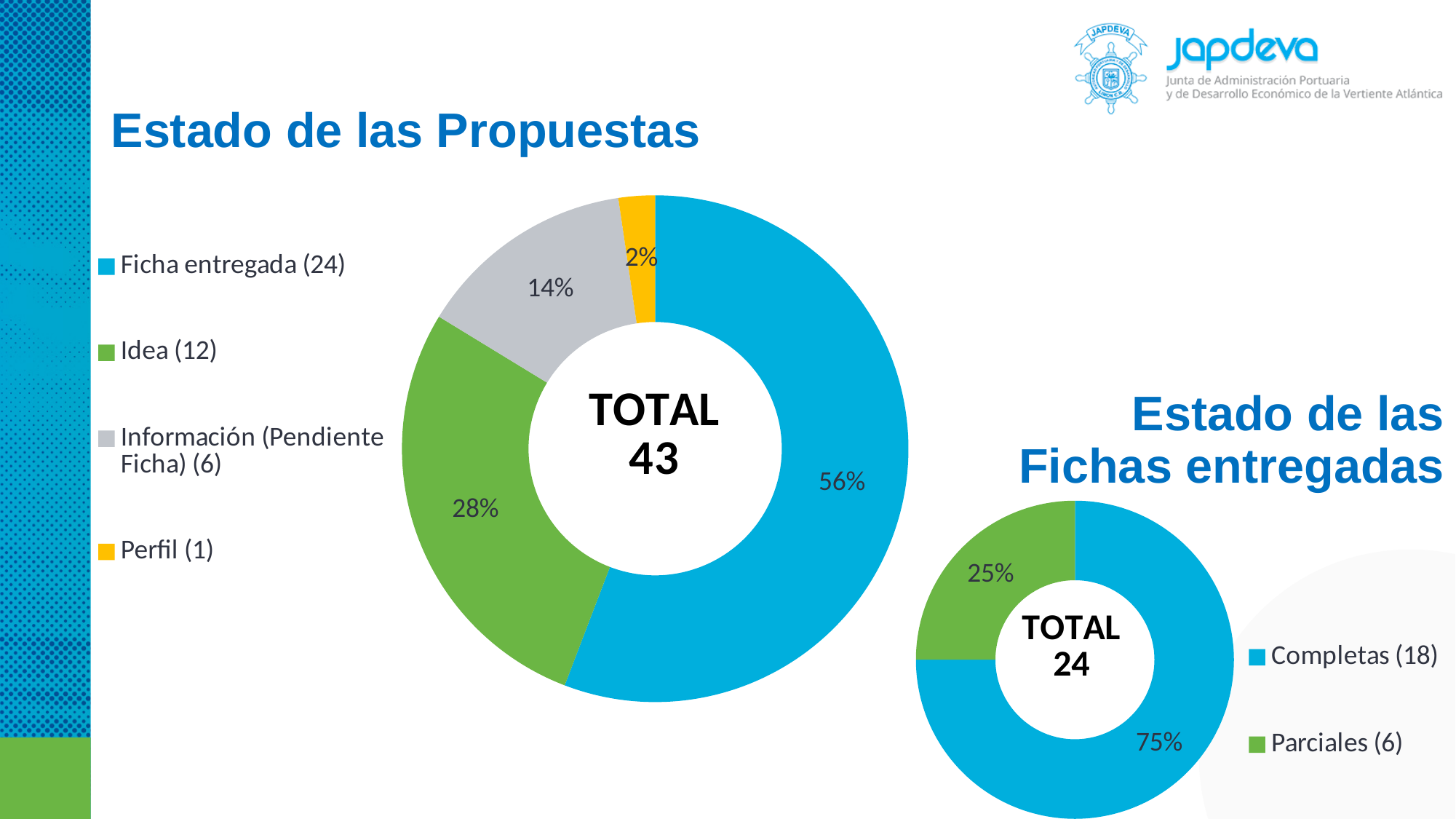
In the 'Estado de las Propuestas' chart, how many categories does the legend list? 4 In the 'Estado de las Fichas entregadas' chart, what count is shown in the legend for 'Parciales'? 6 In the 'Estado de las Fichas entregadas' chart, what percentage share does 'Completas' have? 75% In the 'Estado de las Propuestas' chart, what percentage share does 'Ficha entregada' have? 56% In the 'Estado de las Propuestas' chart, what is the difference in percentage points between 'Ficha entregada' and 'Idea'? 28 In the 'Estado de las Propuestas' chart, what percentage share does 'Información (Pendiente Ficha)' have? 14% In the 'Estado de las Propuestas' chart, which category has the smallest share? Perfil What kind of chart is the 'Estado de las Fichas entregadas' chart? Pie (donut) chart In the 'Estado de las Propuestas' chart, which category has the largest share? Ficha entregada In the 'Estado de las Propuestas' chart, what is the total shown in the centre of the donut? 43 In the 'Estado de las Fichas entregadas' chart, which is larger, 'Completas' or 'Parciales'? Completas